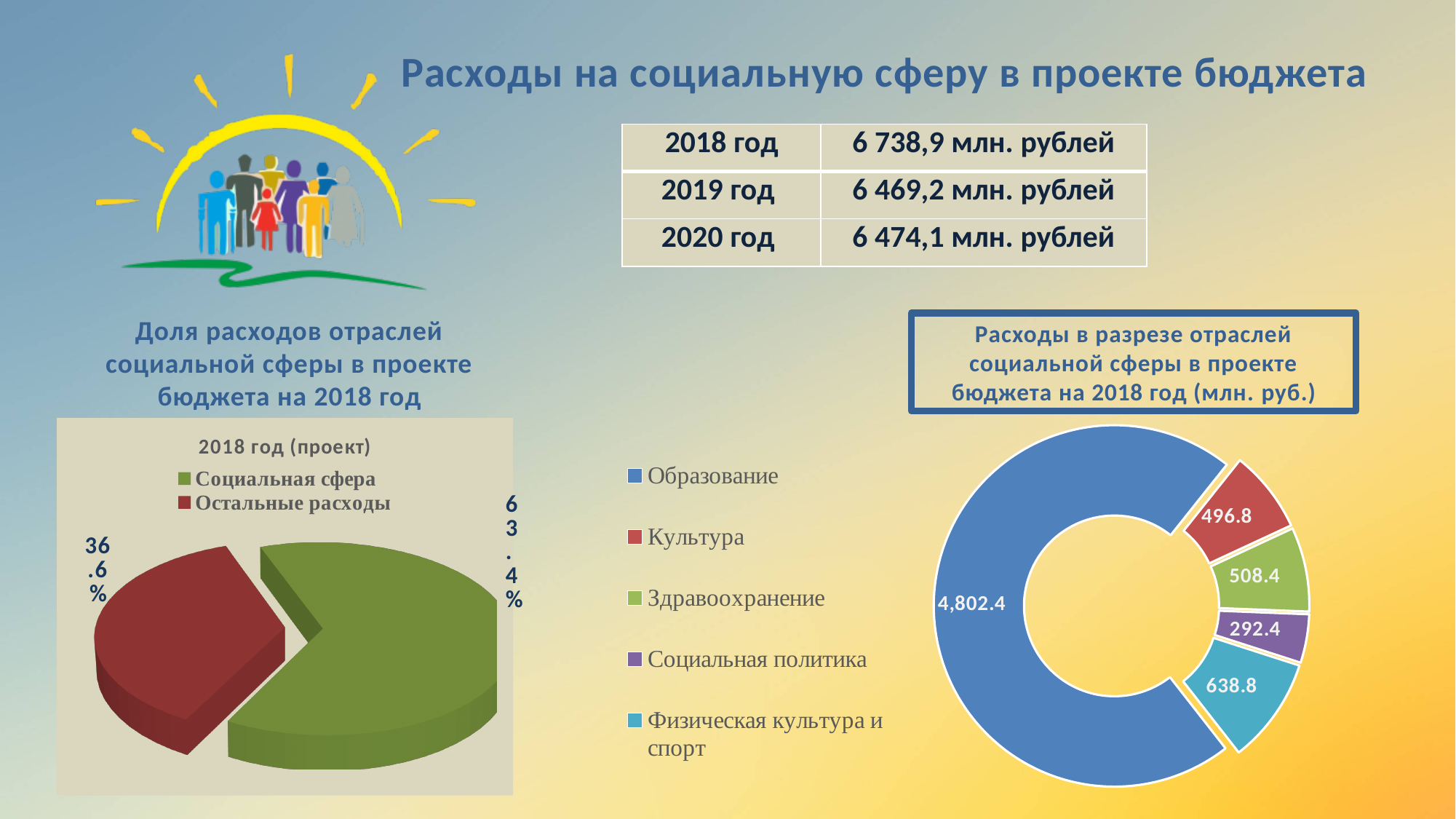
What type of chart is the chart on the left titled '2018 год (проект)'? Pie chart In the doughnut chart on the right, which category has the highest value? Образование In the doughnut chart on the right, what is the value for Образование? 4,802.4 In the pie chart on the left titled '2018 год (проект)', what share does Социальная сфера have? 63.4% How many categories does the doughnut chart on the right show? 5 In the doughnut chart on the right, which category has the lowest value? Социальная политика In the pie chart on the left, what colour is the Социальная сфера slice? Green In the doughnut chart on the right, what is the value for Социальная политика? 292.4 In the doughnut chart on the right, what is the value for Физическая культура и спорт? 638.8 In the doughnut chart on the right, which is larger: Культура or Здравоохранение? Здравоохранение In the doughnut chart on the right, what is the difference between Физическая культура и спорт and Социальная политика? 346.4 In the pie chart on the left titled '2018 год (проект)', what share does Остальные расходы have? 36.6%